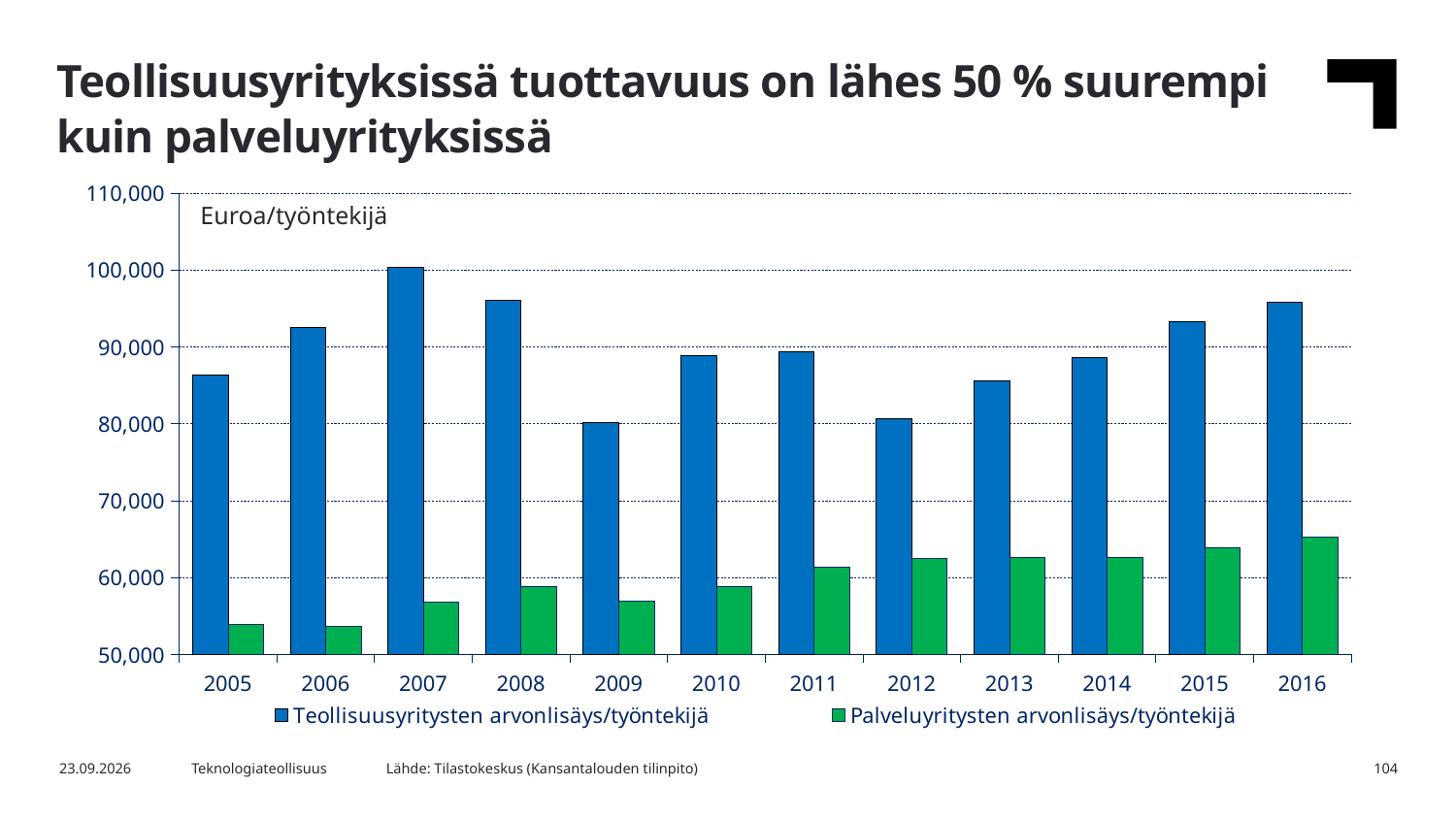
Is the value for Palveluyritysten arvonlisäys/työntekijä in 2005 greater or less than 60,000? less Is the value for Palveluyritysten arvonlisäys/työntekijä in 2016 greater or less than 60,000? greater How many series does the legend list? 2 In which year is the value for Teollisuusyritysten arvonlisäys/työntekijä highest? 2007 What kind of chart is shown on the slide? bar chart How many years are shown on the x axis? 12 Is the value for Teollisuusyritysten arvonlisäys/työntekijä in 2009 greater or less than 90,000? less In which year is the value for Palveluyritysten arvonlisäys/työntekijä highest? 2016 What unit label is printed inside the chart area? Euroa/työntekijä Which is larger for Teollisuusyritysten arvonlisäys/työntekijä: the value in 2007 or in 2008? 2007 Does the value for Palveluyritysten arvonlisäys/työntekijä generally rise or fall from 2005 to 2016? rise